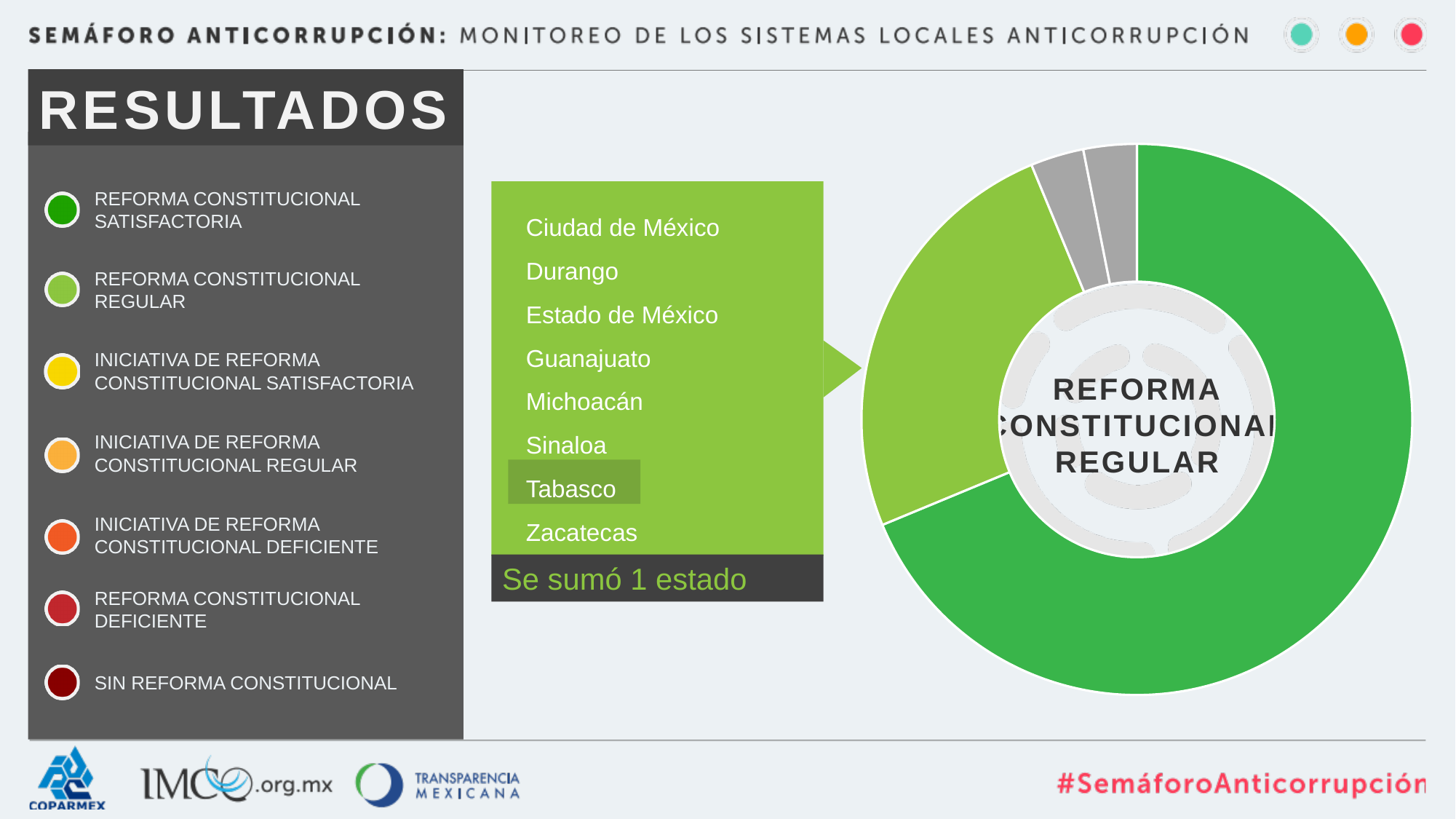
Which state is listed last in the callout box for the light green slice? Zacatecas Is the dark green slice of the donut chart greater or less than half of the chart? greater What text is written in the centre of the donut chart? REFORMA CONSTITUCIONAL REGULAR Which category, according to the colour key on the left, has the largest slice in the donut chart? Reforma constitucional satisfactoria Which state is highlighted in the callout box for Reforma constitucional regular? Tabasco What kind of chart is shown on the right of the slide? Pie (donut) chart Which slice is larger in the donut chart: the light green one or either of the grey ones? The light green one Which slice is larger in the donut chart: the dark green one or the light green one? The dark green one Which state is listed first in the callout box for the light green slice? Ciudad de México How many states are listed in the green callout box pointing to the light green slice? 8 According to the callout box, how many states were added to the Reforma constitucional regular category? 1 How many slices does the donut chart have? 4